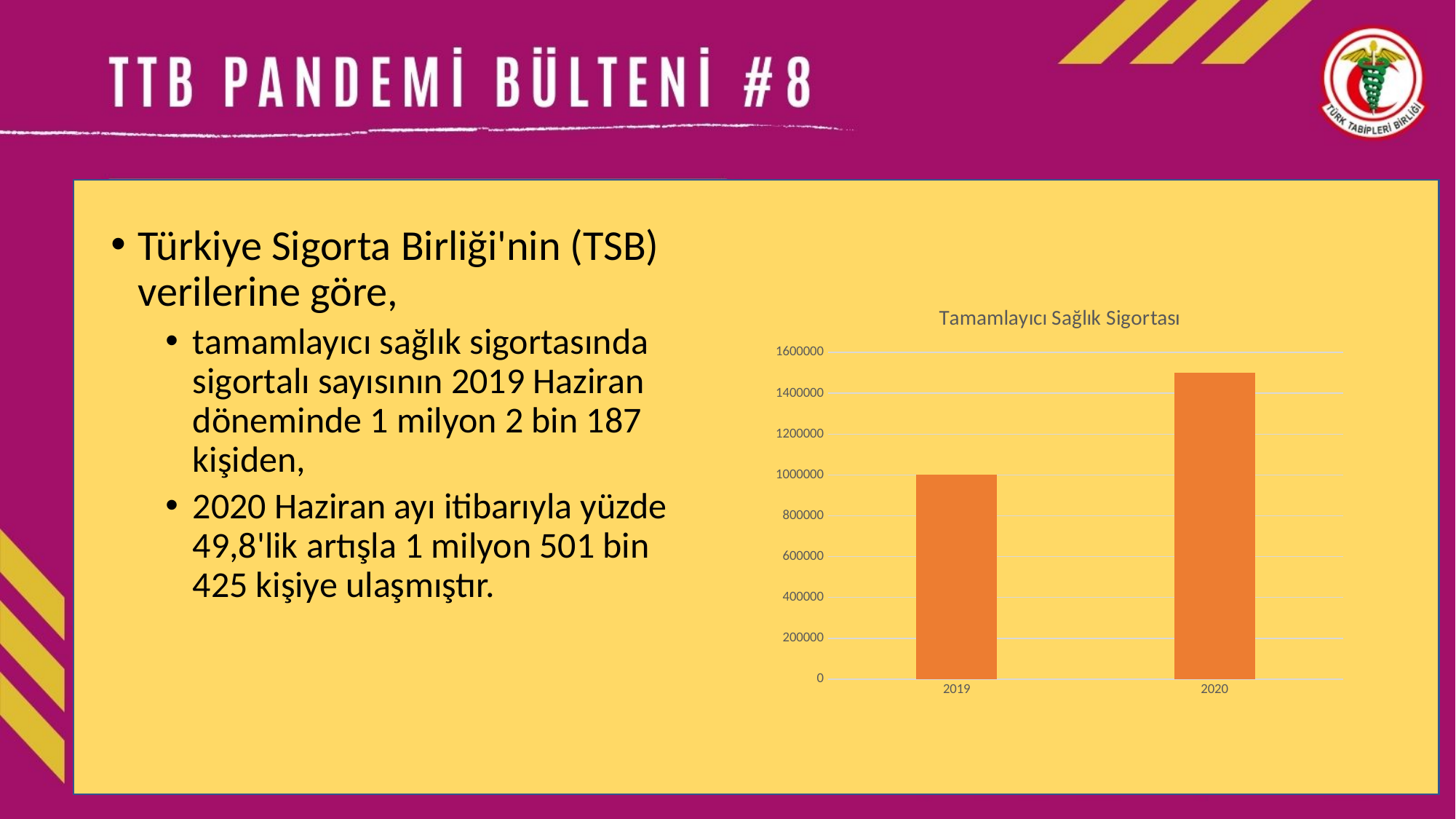
How many categories are shown on the x axis of the chart? 2 What colour are the bars in the chart? orange Is the value for 2019 greater or less than 1200000? less What kind of chart is shown on the slide? bar chart Which year has the highest bar in the chart? 2020 Is the value for 2020 greater or less than 1600000? less Do the values rise or fall from 2019 to 2020? rise Is the value for 2020 greater or less than 1400000? greater Which year has the lowest bar in the chart? 2019 Which bar is taller, 2019 or 2020? 2020 What is the title of the chart? Tamamlayıcı Sağlık Sigortası